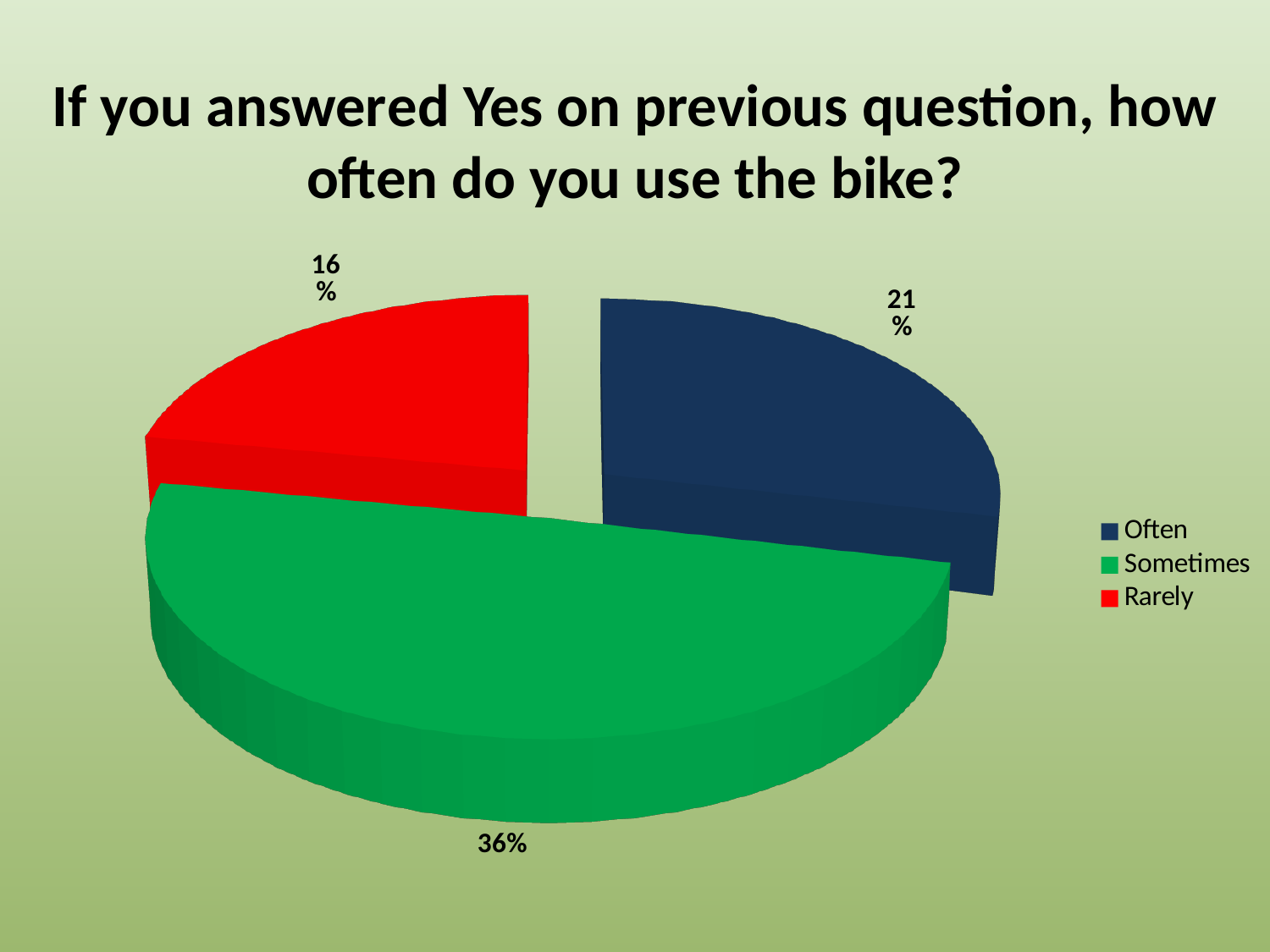
What percentage is shown for the Sometimes slice? 36% Which category has the largest slice of the pie? Sometimes What percentage is shown for the Rarely slice? 16% Which category has the smallest slice of the pie? Rarely What type of chart is shown on the slide? Pie chart Which is larger, the Often slice or the Rarely slice? Often Which is larger, the Sometimes slice or the Often slice? Sometimes What colour is the Sometimes slice in the pie chart? Green How many categories are shown in the pie chart? 3 What is the difference in percentage points between the Sometimes and Often slices? 15 What is the difference in percentage points between the Often and Rarely slices? 5 What percentage is shown for the Often slice? 21%